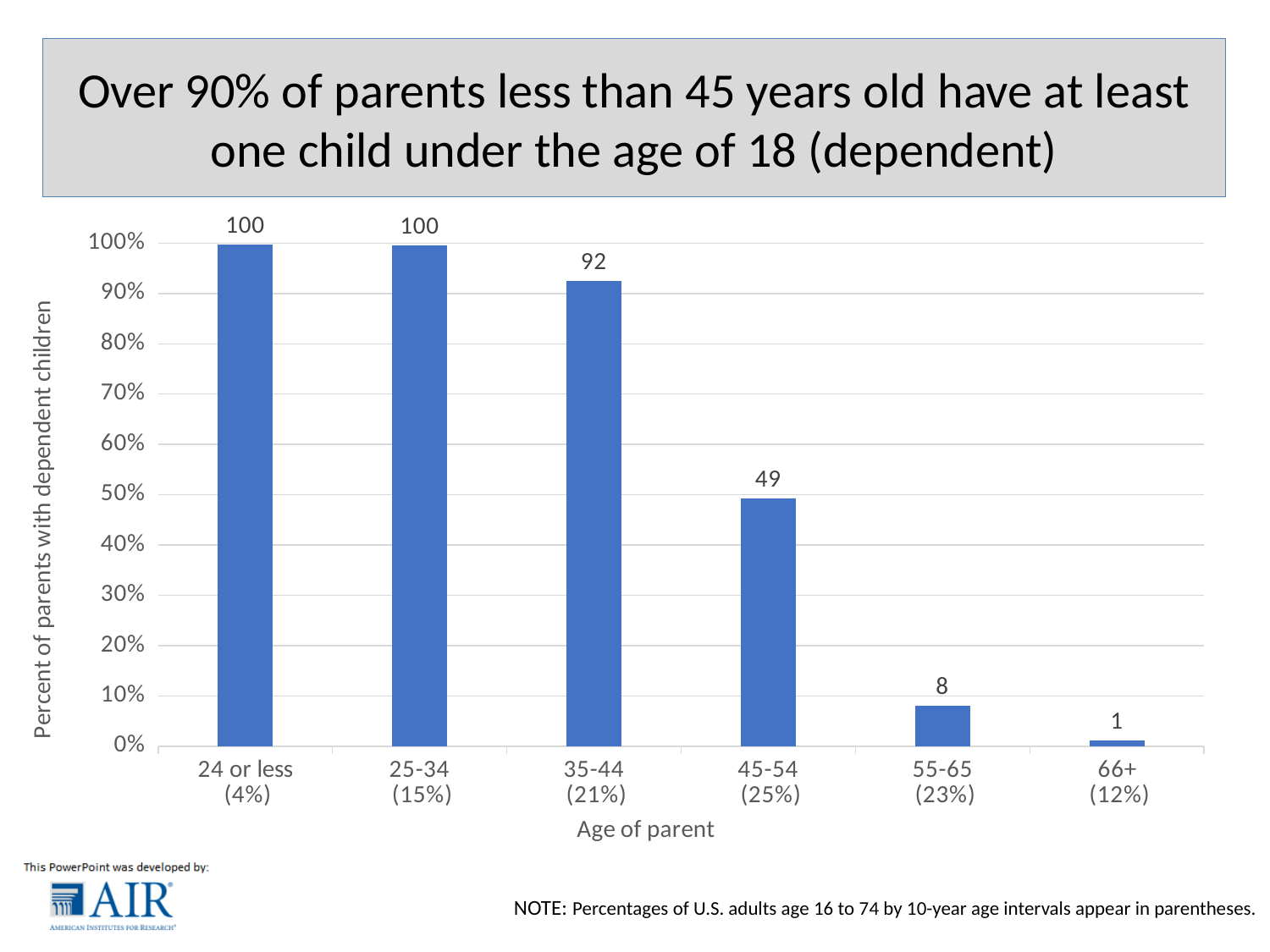
Which is larger, the value for 35-44 or the value for 45-54? 35-44 What is the label of the y axis? Percent of parents with dependent children Is the value for 45-54 greater or less than 60%? less What is the value for the 45-54 age group? 49 What is the value for the 55-65 age group? 8 What is the difference between the values for 35-44 and 45-54? 43 What is the difference between the values for 45-54 and 55-65? 41 What is the value for the 35-44 age group? 92 What kind of chart is shown on the slide? bar chart Do the values rise or fall as age of parent increases along the x axis? fall Which age group has the lowest value? 66+ How many age groups are shown on the x axis? 6